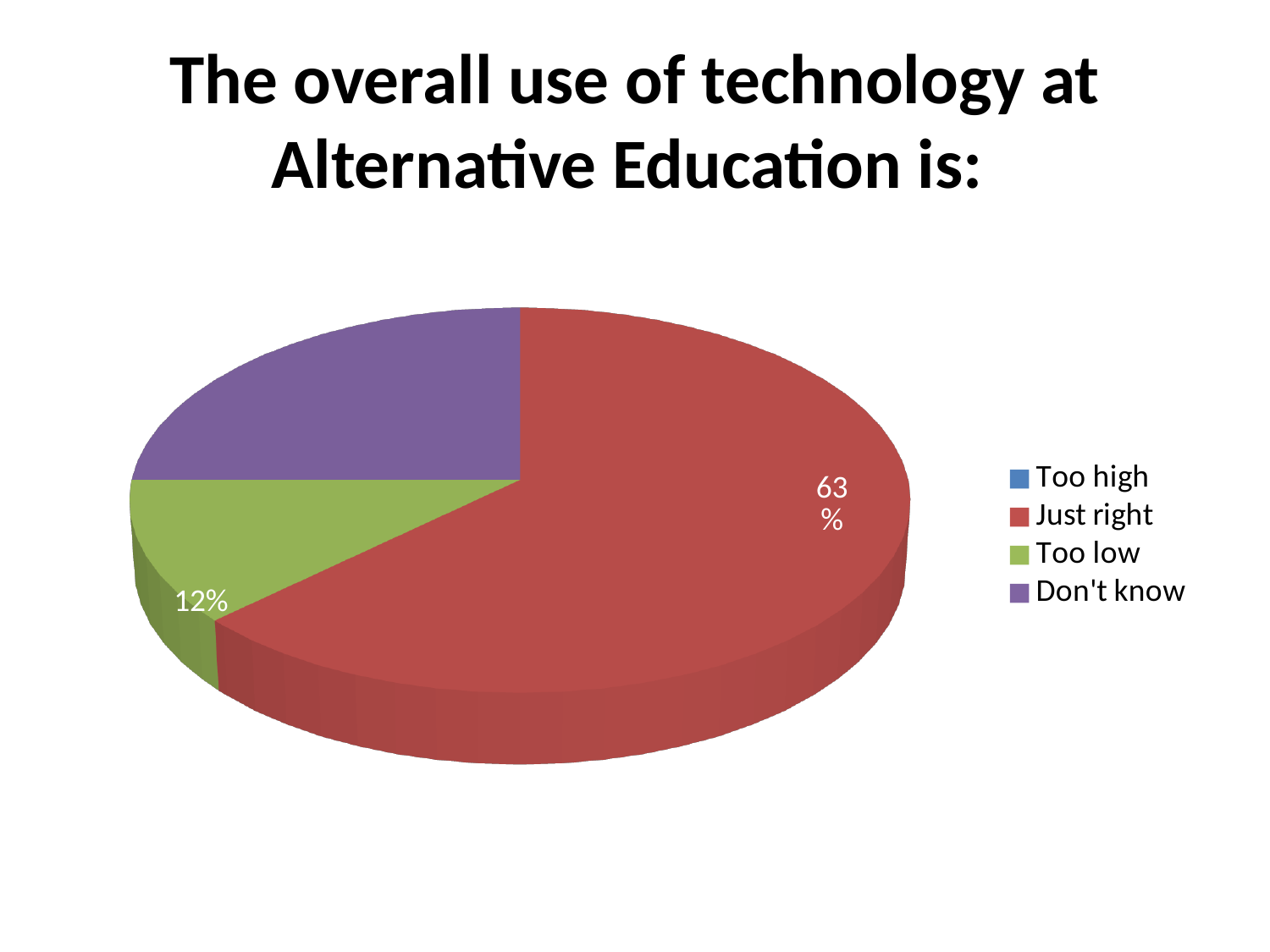
What share of the pie does the "Just right" slice represent? 63% What percentage of the pie is labelled for "Too low"? 12% Is the "Just right" slice greater or less than 50% of the pie? greater Which slice is larger, "Don't know" or "Too low"? Don't know How many categories does the legend list? 4 Which category has the largest slice of the pie? Just right Which slice is larger, "Just right" or "Too low"? Just right What percentage of the pie is labelled for "Just right"? 63% What colour is the "Just right" slice in the pie chart? red What is the difference in percentage points between the "Just right" slice and the "Too low" slice? 51 What kind of chart is shown on the slide? pie chart What is the title of the slide? The overall use of technology at Alternative Education is: